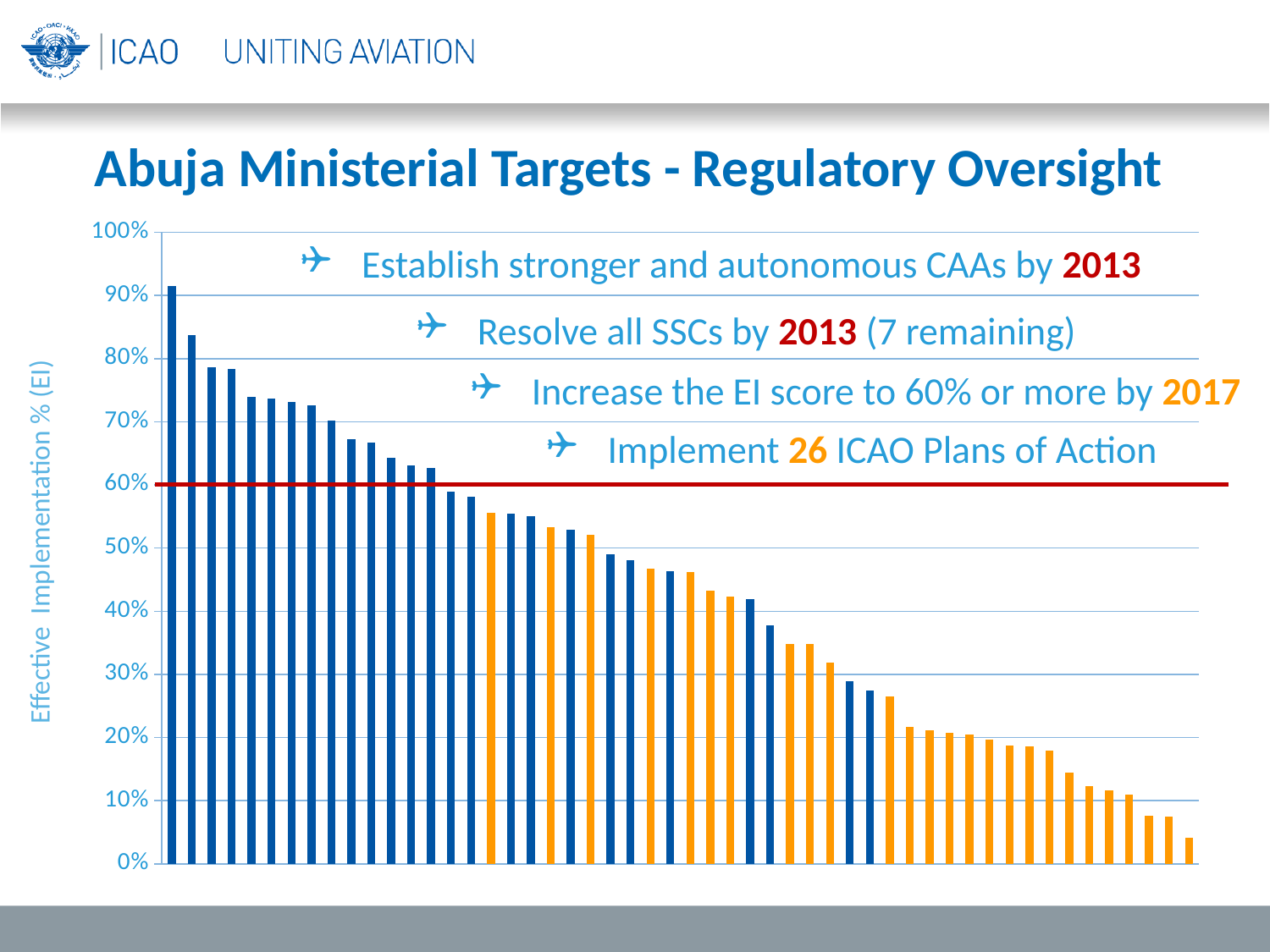
What is the highest value shown on the vertical axis? 100% Is the value of the third bar from the left greater or less than 70%? greater At what value on the vertical axis is the red horizontal line drawn? 60% What kind of chart is shown on the slide? bar chart How many orange bars are there in the chart? 26 Is the value of the shortest (rightmost) bar greater or less than 10%? less Which bar is larger, the leftmost bar or the rightmost bar? the leftmost bar What is the label on the vertical axis of the chart? Effective Implementation % (EI) Is the value of the tallest (leftmost) bar greater or less than 80%? greater Do the bar values rise or fall from left to right across the chart? fall